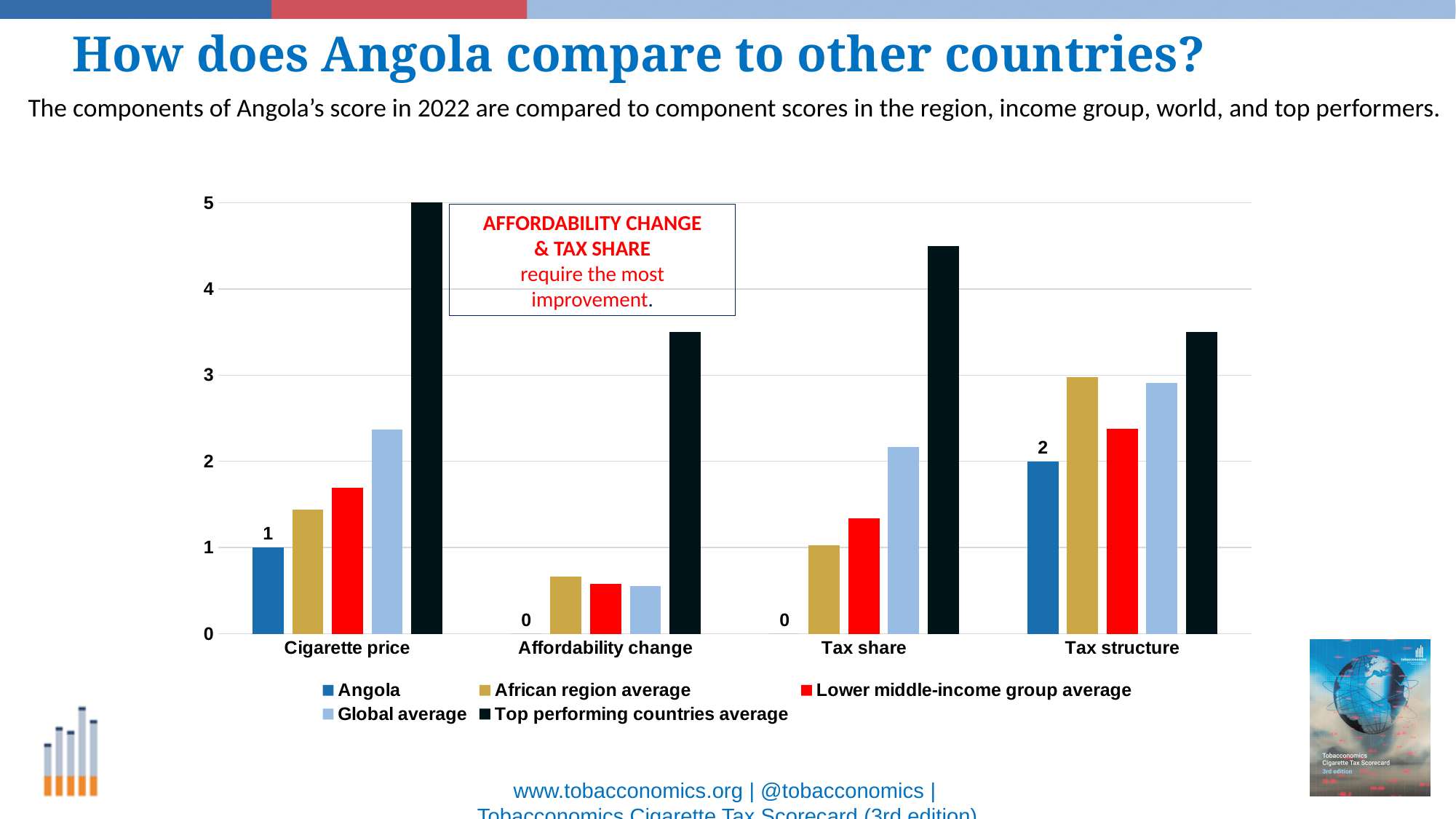
What is the difference between Angola's Tax structure score and its Cigarette price score? 1 What is Angola's score for Affordability change? 0 What is Angola's score for Cigarette price? 1 What is Angola's score for Tax structure? 2 In which component does Angola have its highest score? Tax structure Is the Top performing countries average for Tax share greater or less than 4? greater For Cigarette price, which is larger: Angola's score or the African region average? African region average How many series does the legend list? 5 What kind of chart is shown on the slide? Bar chart Is the Global average for Cigarette price greater or less than 2? greater What is the Top performing countries average score for Cigarette price? 5 How many component categories are shown on the x axis? 4